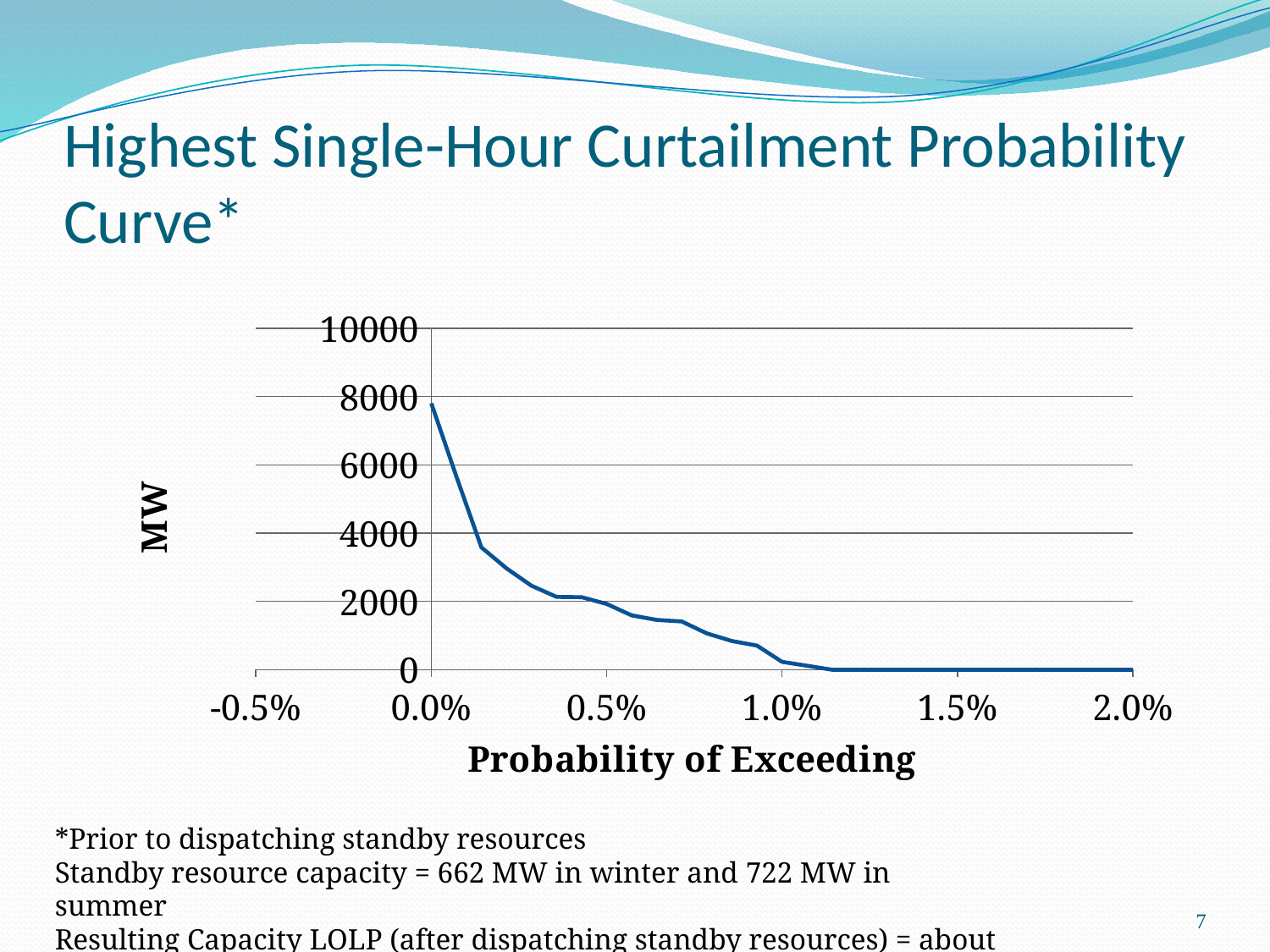
What is the label on the x axis of the chart? Probability of Exceeding Do the values rise or fall as the probability of exceeding increases along the x axis? fall Is the value of the curve at 1.0% probability of exceeding greater or less than 2000 MW? less Is the value of the curve at 0.5% probability of exceeding greater or less than 4000 MW? less Is the value of the curve at 1.5% probability of exceeding greater or less than 2000 MW? less What kind of chart is shown on the slide? line chart Which is larger: the value of the curve at 0.0% or at 1.0% probability of exceeding? 0.0% What is the label on the y axis of the chart? MW At which probability of exceeding shown on the x axis is the curve at its highest? 0.0%